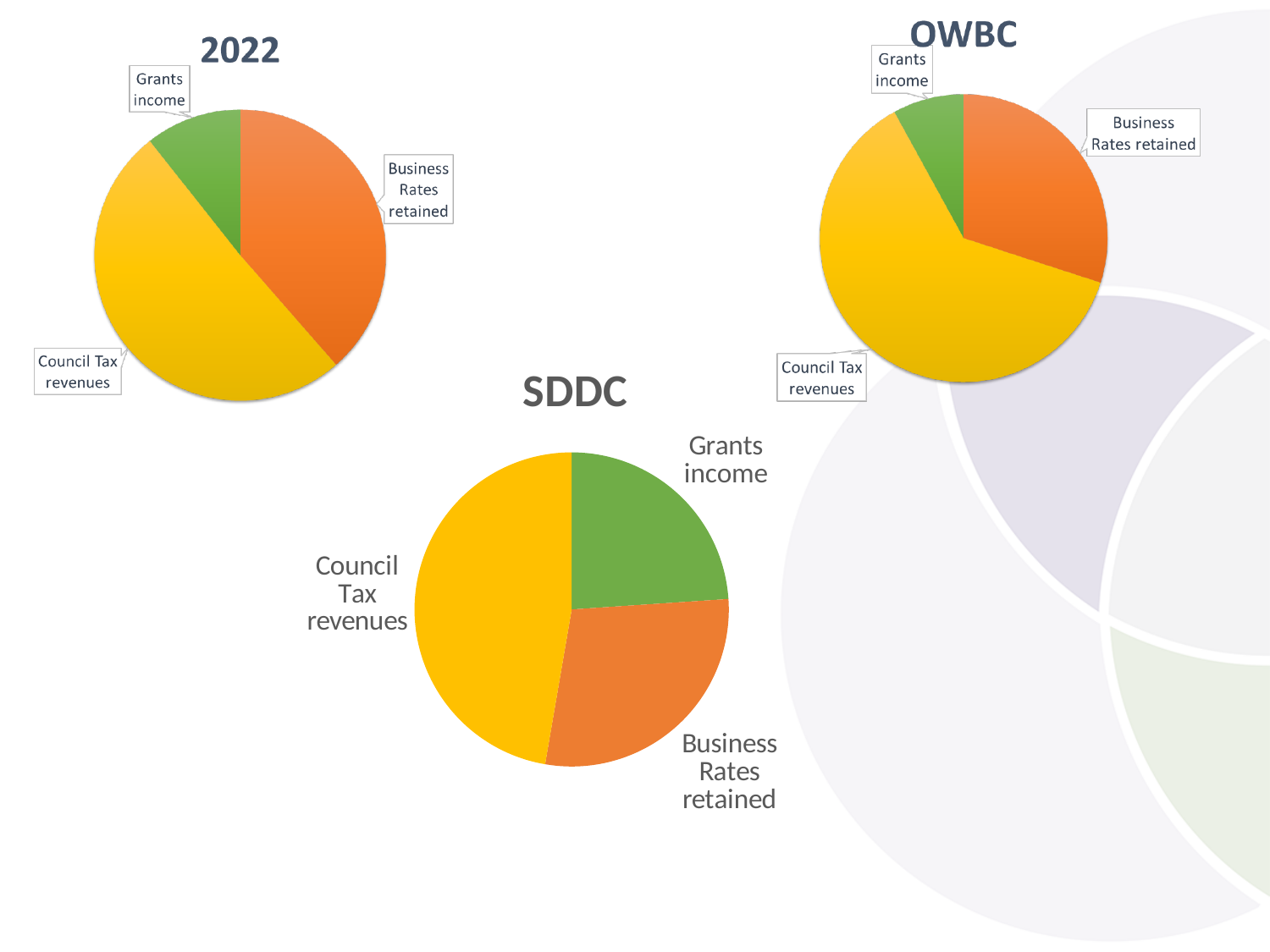
What kind of chart is the chart titled OWBC? pie chart What kind of chart is the chart titled 2022? pie chart In the chart titled OWBC, which is larger: Council Tax revenues or Business Rates retained? Council Tax revenues In the chart titled OWBC, which category has the smallest slice? Grants income In the chart titled 2022, which category has the smallest slice? Grants income In the chart titled SDDC, what colour is the Grants income slice? green In the chart titled OWBC, which category has the largest slice? Council Tax revenues How many slices does the pie chart titled SDDC have? 3 In the chart titled 2022, which category has the largest slice? Council Tax revenues In the chart titled SDDC, which category has the largest slice? Council Tax revenues In the chart titled 2022, which is larger: Business Rates retained or Grants income? Business Rates retained How many pie charts are shown on the slide? 3